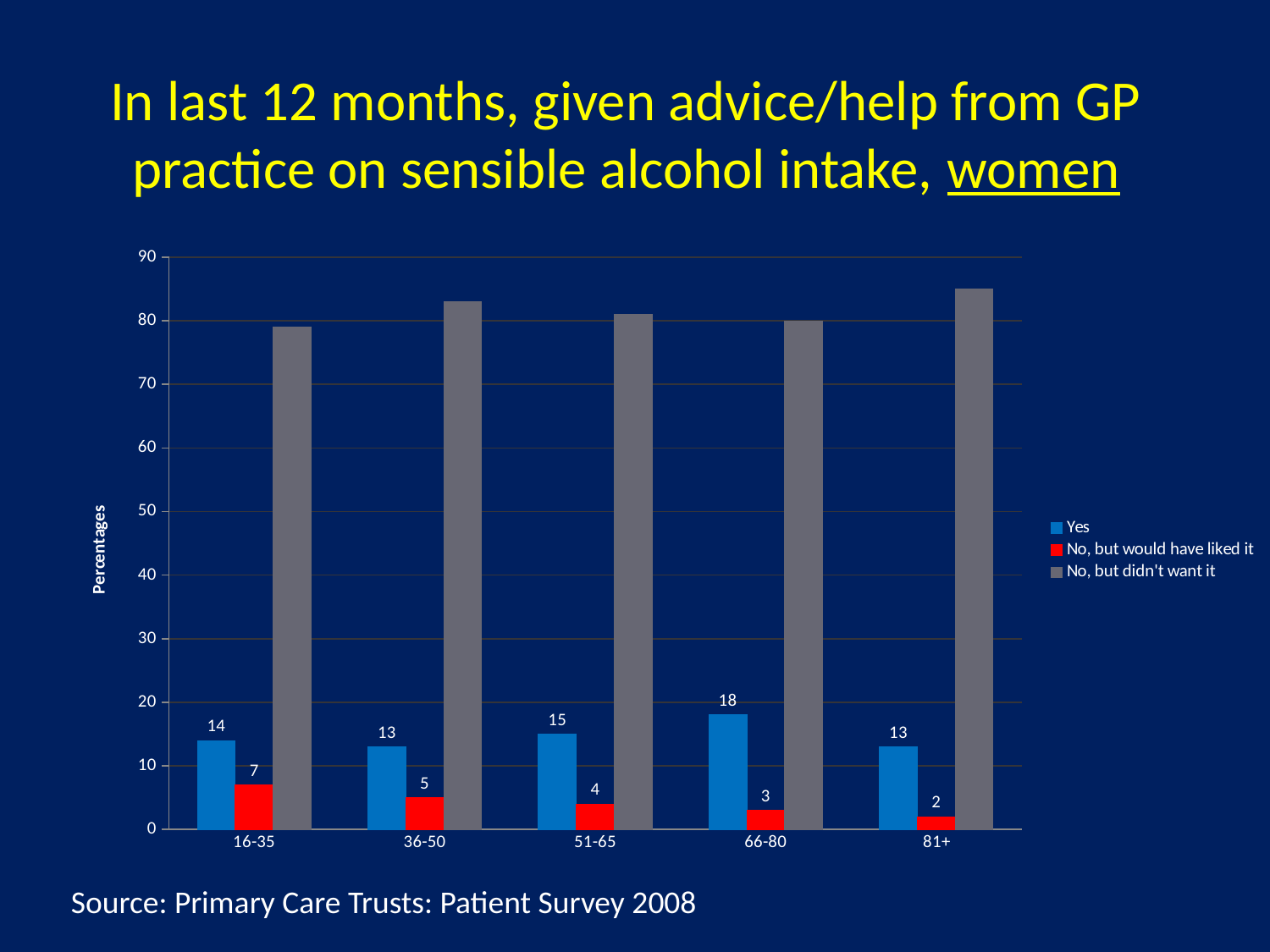
Is the value for "No, but didn't want it" in the 81+ age group greater or less than 80? greater What kind of chart is shown on the slide? bar chart How many series does the legend list? 3 What is the difference between the "Yes" value and the "No, but would have liked it" value for the 36-50 age group? 8 Which is larger: the "Yes" value for 16-35 or the "Yes" value for 66-80? 66-80 What is the value for "No, but would have liked it" in the 16-35 age group? 7 How many age groups are shown on the x axis? 5 Which age group has the lowest value for "No, but would have liked it"? 81+ What percentage of women aged 66-80 answered "Yes"? 18 Do the values for "No, but would have liked it" rise or fall as age group increases along the x axis? fall Which age group has the highest "Yes" value? 66-80 What is the "Yes" value for the 51-65 age group? 15